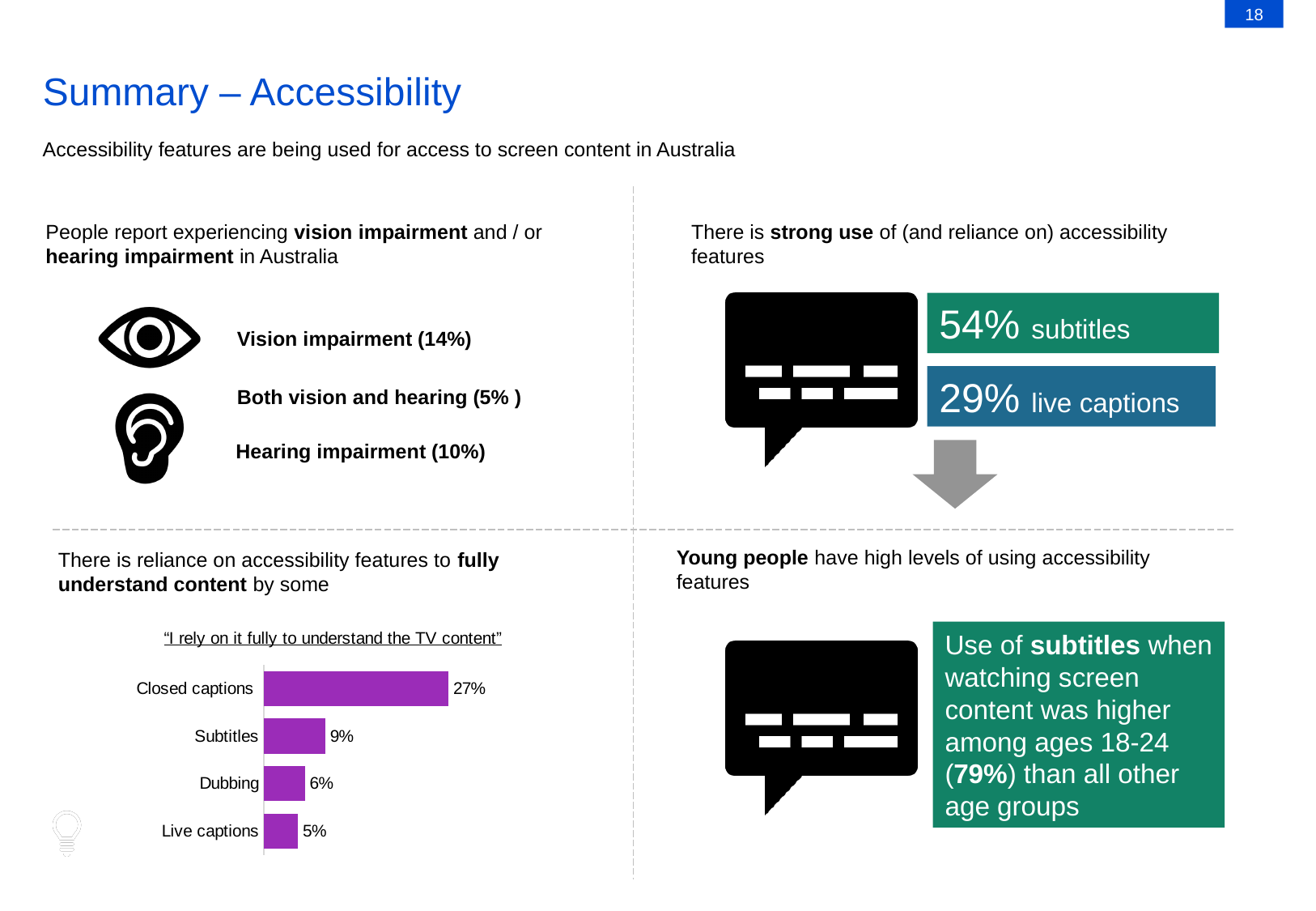
In the bar chart, which is larger: the value for Subtitles or the value for Dubbing? Subtitles What is the value for Subtitles in the bar chart? 9% What is the value for Dubbing in the bar chart? 6% How many categories are shown in the bar chart? 4 Which category has the highest value in the bar chart? Closed captions What is the value for Live captions in the bar chart? 5% Which category has the lowest value in the bar chart? Live captions What kind of chart is shown on the slide? Bar chart What is the difference between the values for Dubbing and Live captions in the bar chart? 1% What is the title of the bar chart on the slide? "I rely on it fully to understand the TV content" What is the value for Closed captions in the "I rely on it fully to understand the TV content" chart? 27% What is the difference between the values for Closed captions and Subtitles in the bar chart? 18%